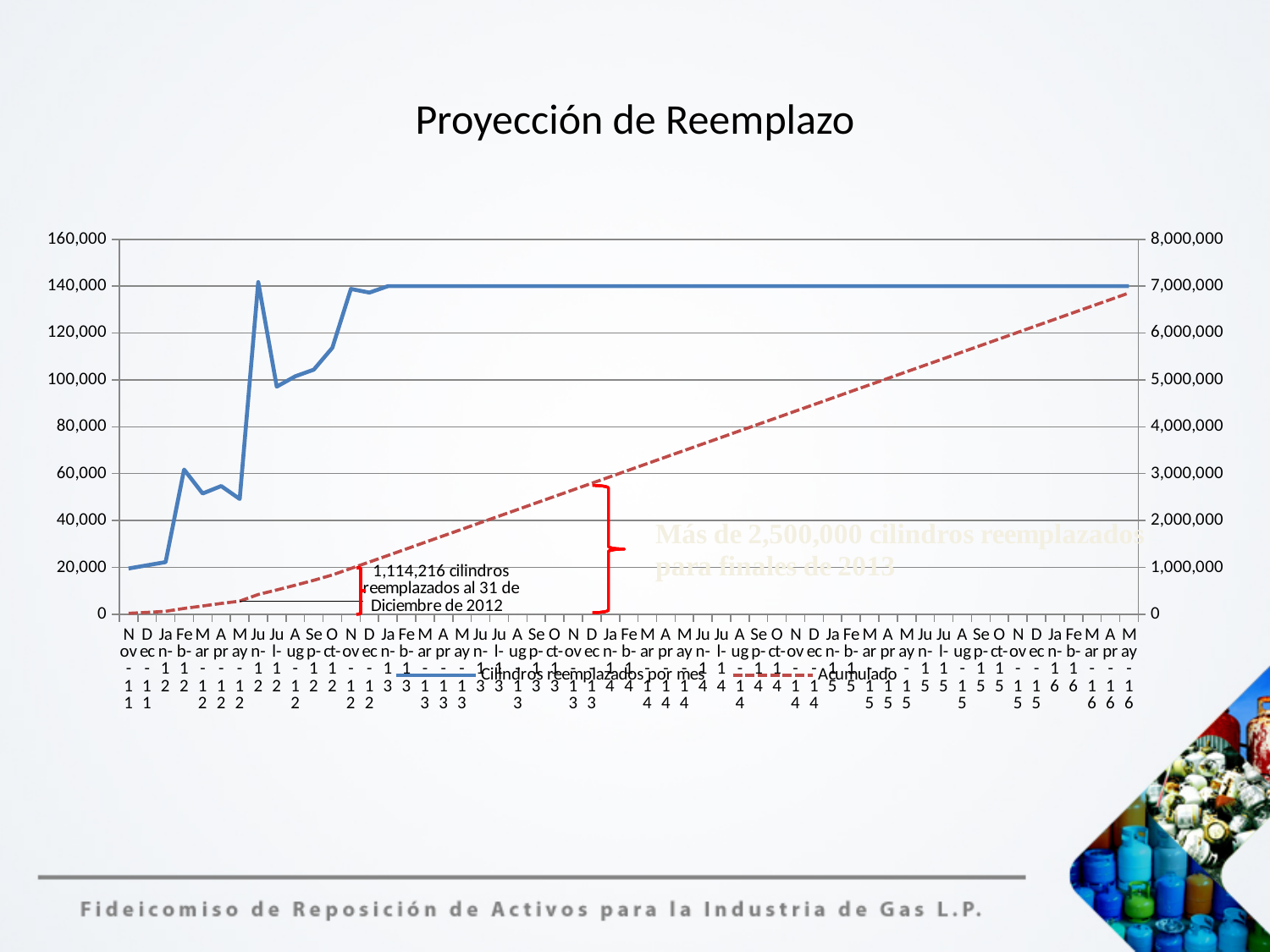
Which series is drawn as a red dashed line? Acumulado Is the plateau value of the Cilindros reemplazados por mes series greater or less than 120,000? greater What is the highest value shown on the left vertical axis? 160,000 What is the title of the chart? Proyección de Reemplazo Does the Acumulado series rise or fall along the x axis? rises What kind of chart is shown on the slide? line chart Is the value of the Acumulado series at the first point (Nov-11) greater or less than 1,000,000? less Is the value of Cilindros reemplazados por mes at the first point (Nov-11) greater or less than 40,000? less According to the annotation on the chart, how many cylinders had been replaced as of 31 December 2012? 1,114,216 How many series does the chart legend list? 2 What is the highest value shown on the right vertical axis? 8,000,000